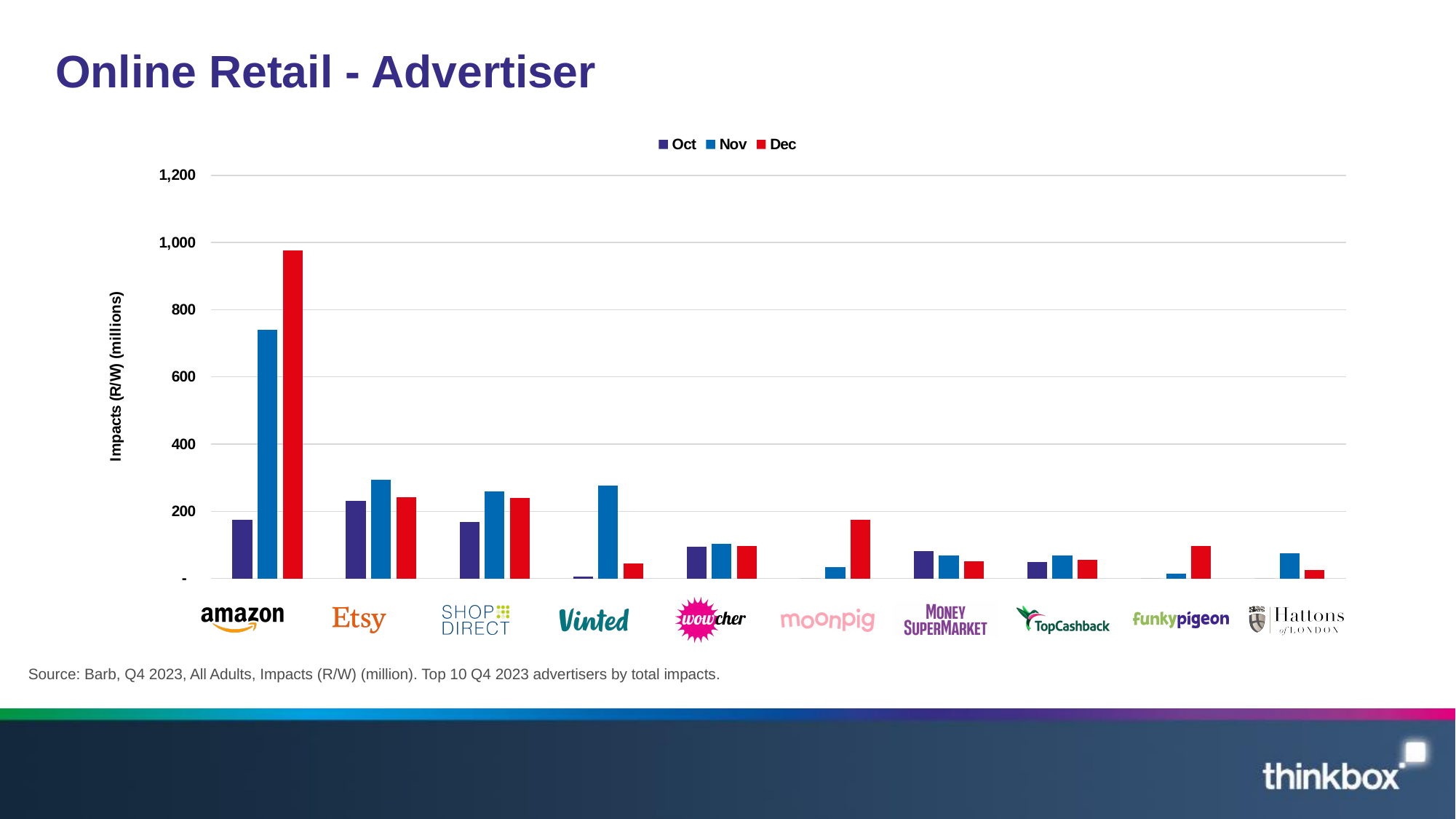
Is the Nov value for Amazon greater or less than 600? greater How many series does the legend list? 3 Is the Dec value for Moonpig greater or less than 200? less For Etsy, which month has the larger value, Oct or Nov? Nov Do Amazon's values rise or fall from Oct to Dec? Rise For Vinted, which month has the larger value, Nov or Dec? Nov Which advertiser has the tallest bar on the chart? Amazon Is the Dec value for Amazon greater or less than 800? greater Do MoneySuperMarket's values rise or fall from Oct to Dec? Fall What kind of chart is shown on the slide? Bar chart How many advertisers are shown along the x axis? 10 What are the three entries in the chart legend? Oct, Nov, Dec